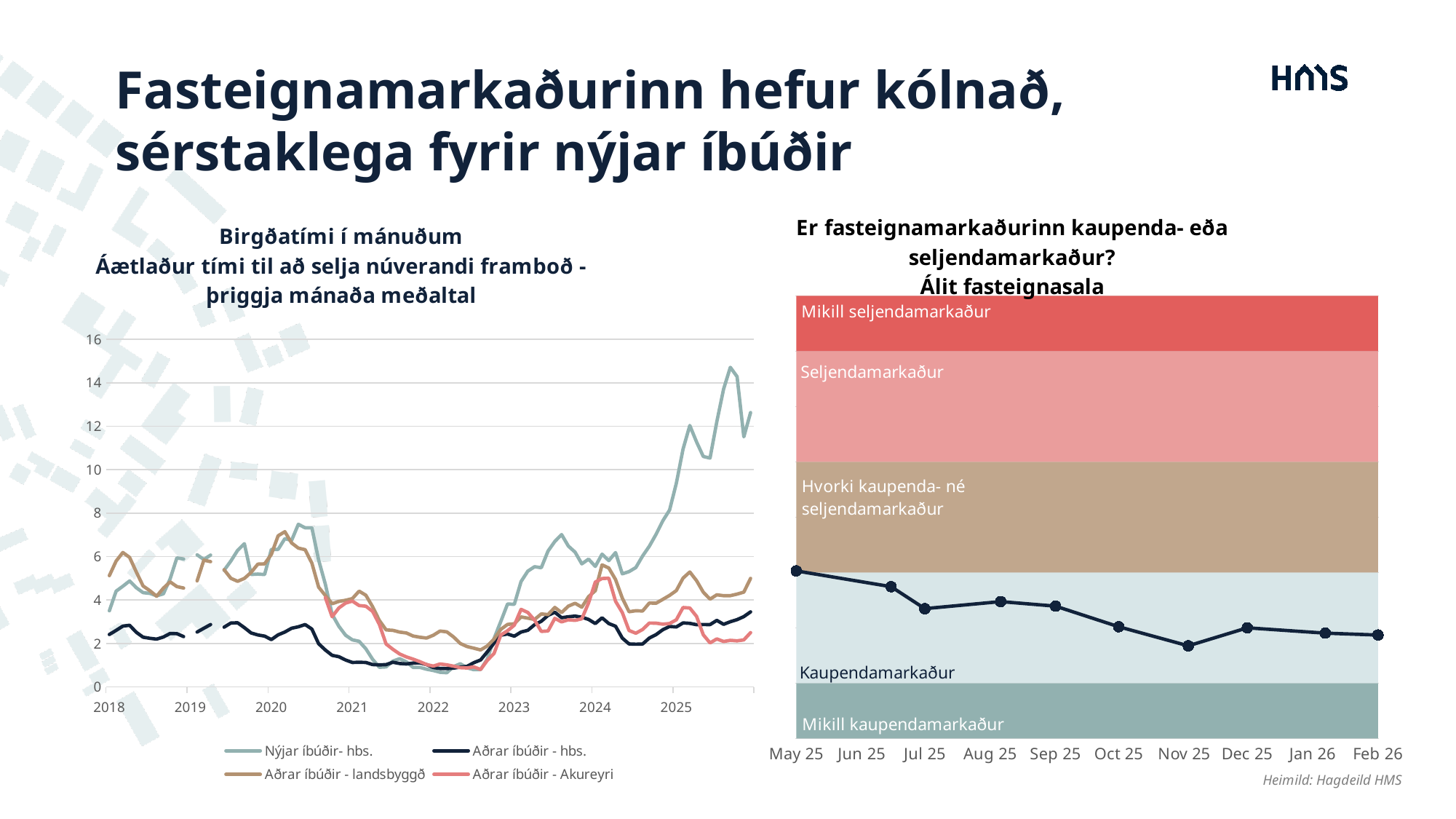
In the left chart 'Birgðatími í mánuðum', what is the highest value shown on the y axis? 16 In the left chart 'Birgðatími í mánuðum', how many series does the legend list? 4 In the left chart 'Birgðatími í mánuðum', is the peak value of Nýjar íbúðir- hbs. in 2025 greater or less than 14? greater In the right chart 'Er fasteignamarkaðurinn kaupenda- eða seljendamarkaður?', which month has the lowest point? Nov 25 In the left chart 'Birgðatími í mánuðum', which series reaches the highest value during 2025? Nýjar íbúðir- hbs. In the left chart 'Birgðatími í mánuðum', is the value for Aðrar íbúðir - hbs. at the end of 2025 greater or less than 4? less In the right chart 'Er fasteignamarkaðurinn kaupenda- eða seljendamarkaður?', which month has the highest point? May 25 What kind of chart is the left chart titled 'Birgðatími í mánuðum'? line chart In the right chart 'Er fasteignamarkaðurinn kaupenda- eða seljendamarkaður?', how many data points are plotted? 10 In the right chart 'Er fasteignamarkaðurinn kaupenda- eða seljendamarkaður?', which is higher, the point for Dec 25 or the point for Nov 25? Dec 25 In the left chart 'Birgðatími í mánuðum', does the Nýjar íbúðir- hbs. series generally rise or fall from 2024 to the end of 2025? rise In the right chart 'Er fasteignamarkaðurinn kaupenda- eða seljendamarkaður?', does the line rise or fall from May 25 to Nov 25? fall